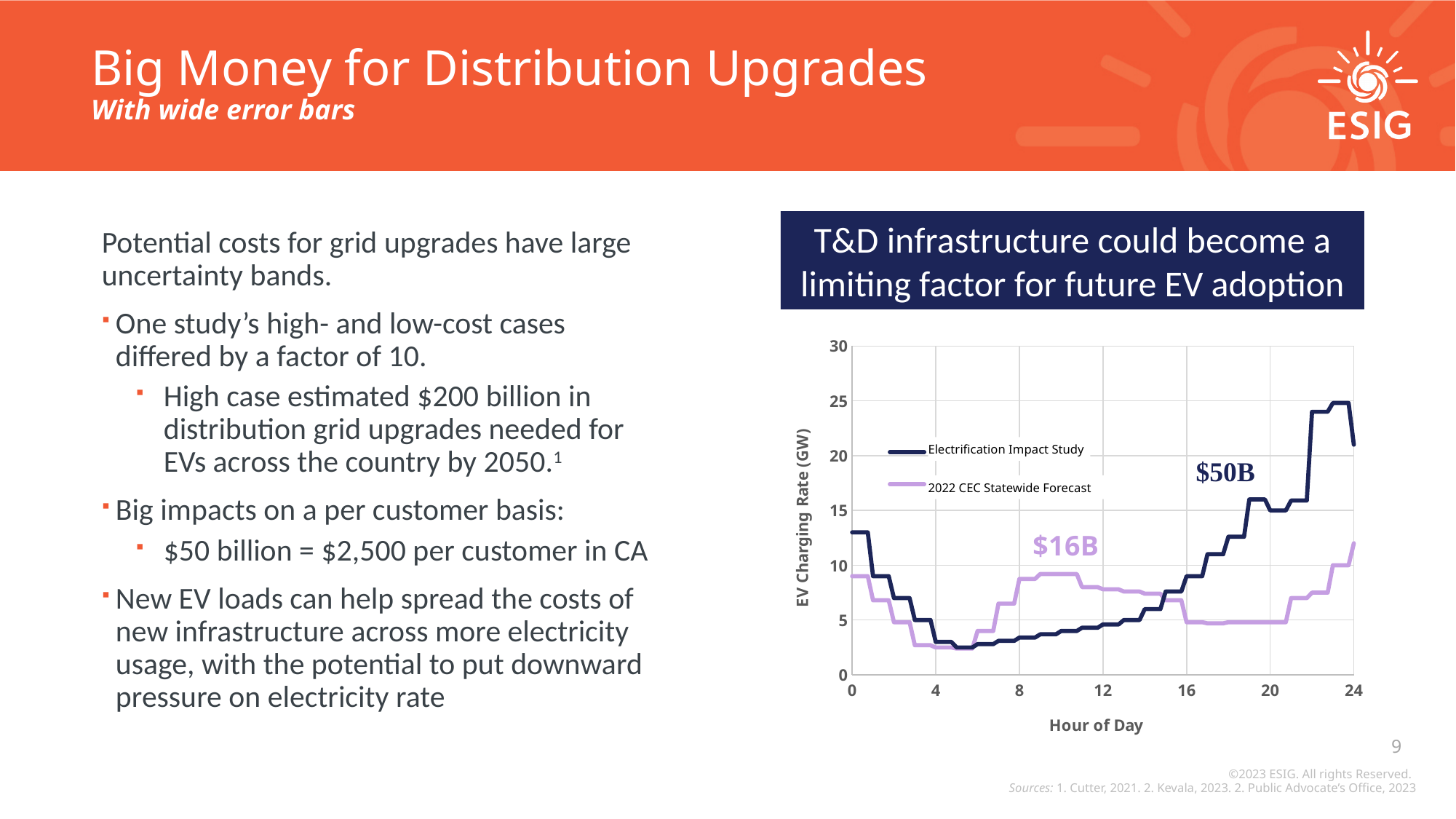
What is the title of the chart's horizontal axis? Hour of Day Is the Electrification Impact Study value at hour 0 greater or less than 10? greater How many series does the chart's legend list? 2 Does the Electrification Impact Study line rise or fall between hour 16 and hour 23? rise What is the title of the chart's vertical axis? EV Charging Rate (GW) At hour 20, which series has the higher EV charging rate? Electrification Impact Study Is the Electrification Impact Study value at hour 5 greater or less than 5? less Is the Electrification Impact Study value at hour 22 greater or less than 20? greater Which series reaches the highest EV charging rate on the chart? Electrification Impact Study What kind of chart is shown on the slide? line chart At hour 8, which series has the higher EV charging rate? 2022 CEC Statewide Forecast